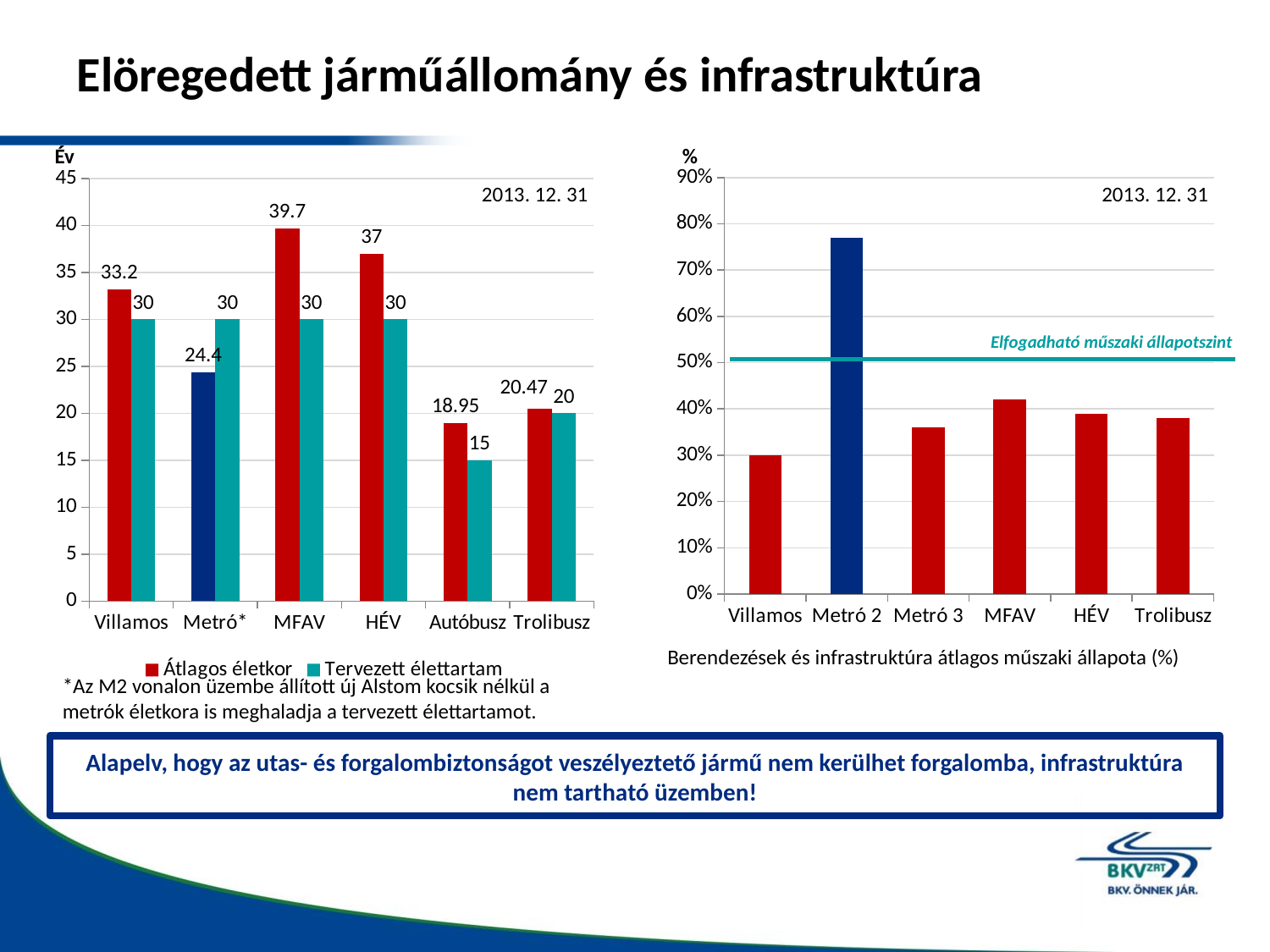
In the right chart (%), how many categories are shown on the x axis? 6 In the left chart (Év), which category has the lowest Átlagos életkor? Autóbusz In the left chart (Év), which is larger for Villamos: Átlagos életkor or Tervezett élettartam? Átlagos életkor In the left chart (Év), how many series does the legend list? 2 In the right chart (%), is the value for Metró 2 greater or less than 70%? greater In the right chart (%), is the value for Villamos greater or less than 40%? less In the left chart (Év), what is the difference between the Átlagos életkor and Tervezett élettartam for HÉV? 7 In the left chart (Év), which category has the highest Átlagos életkor? MFAV In the right chart (%), which category has the highest value? Metró 2 In the left chart (Év), what is the Átlagos életkor value for Metró*? 24.4 In the left chart (Év), what is the Tervezett élettartam value for Autóbusz? 15 In the left chart (Év), what is the Átlagos életkor value for MFAV? 39.7